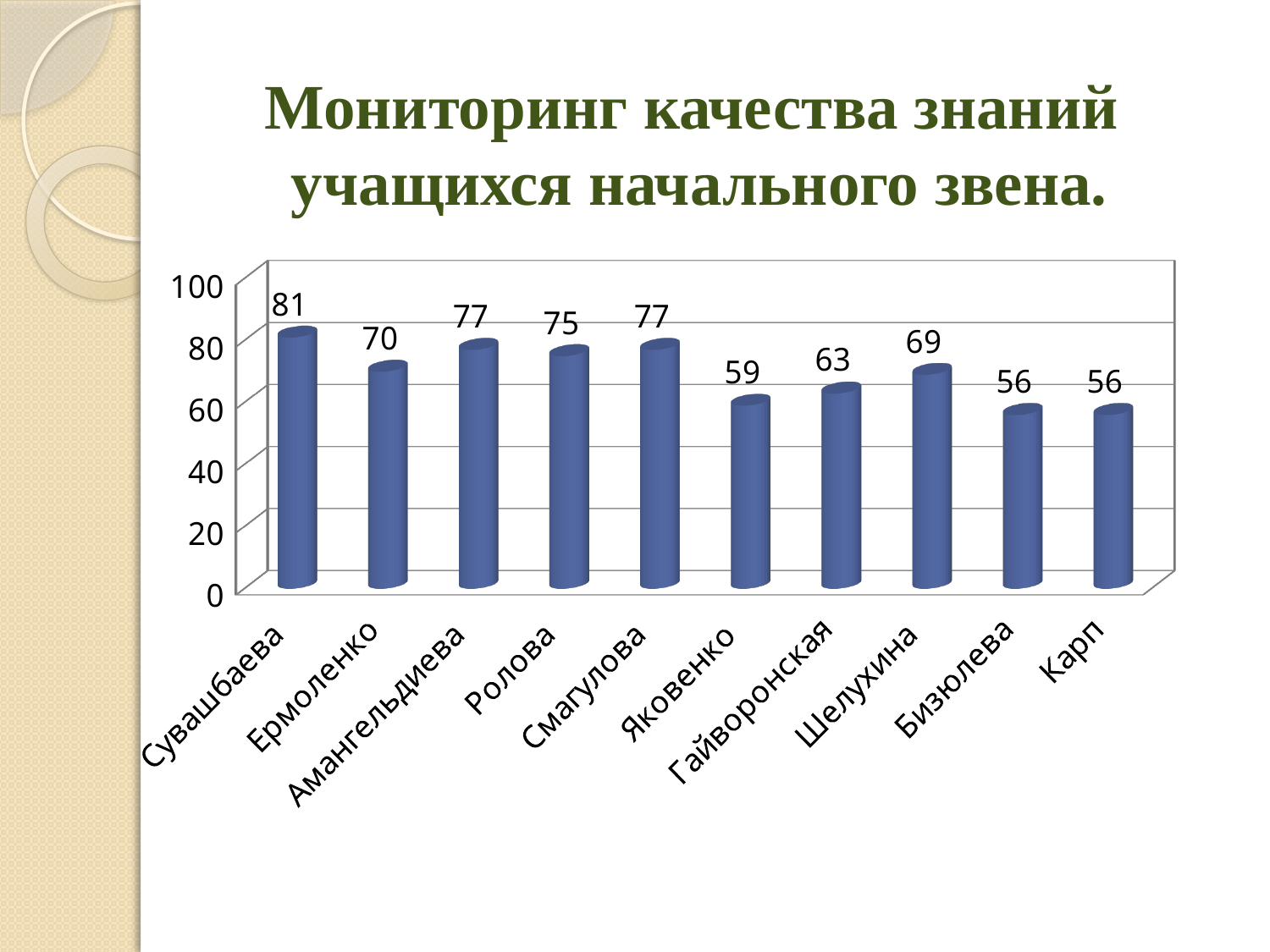
Which category has the highest value? Сувашбаева What kind of chart is shown on the slide? bar chart What is the value for Амангельдиева? 77 How many categories are shown on the x axis? 10 What is the value for Сувашбаева? 81 Is the value for Бизюлева greater or less than 60? less What is the value for Шелухина? 69 Which is larger, the value for Ролова or the value for Яковенко? Ролова What is the difference between the values for Ермоленко and Гайворонская? 7 What is the difference between the values for Сувашбаева and Карп? 25 What is the title of the slide? Мониторинг качества знаний учащихся начального звена. What is the value for Яковенко? 59